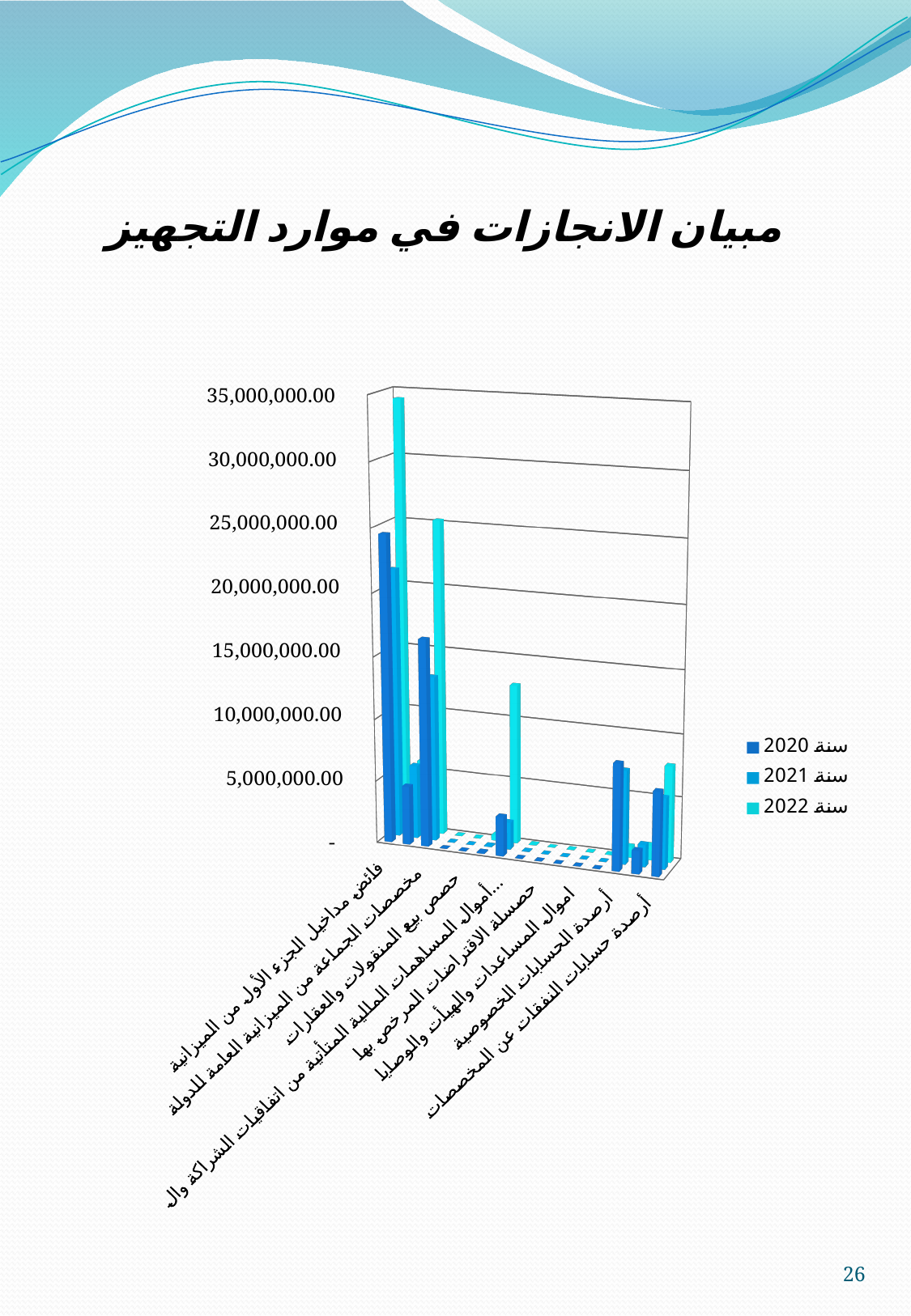
Is the value of سنة 2022 for حصيلة الاقتراضات المرخص بها greater or less than 15,000,000.00? less What is the title of the chart slide? مبيان الانجازات في موارد التجهيز How many series does the legend list? 3 Which category contains the tallest bar in the chart? فائض مداخيل الجزء الأول من الميزانية Is the value of سنة 2022 for فائض مداخيل الجزء الأول من الميزانية greater or less than 30,000,000.00? greater What are the series names listed in the legend? سنة 2020, سنة 2021, سنة 2022 For the category فائض مداخيل الجزء الأول من الميزانية, which series has the highest value? سنة 2022 Is the value of سنة 2020 for فائض مداخيل الجزء الأول من الميزانية greater or less than 20,000,000.00? greater For فائض مداخيل الجزء الأول من الميزانية, which is larger: the value for سنة 2022 or the value for سنة 2020? سنة 2022 What is the highest value shown on the vertical axis of the chart? 35,000,000.00 What kind of chart is shown on the slide? bar chart